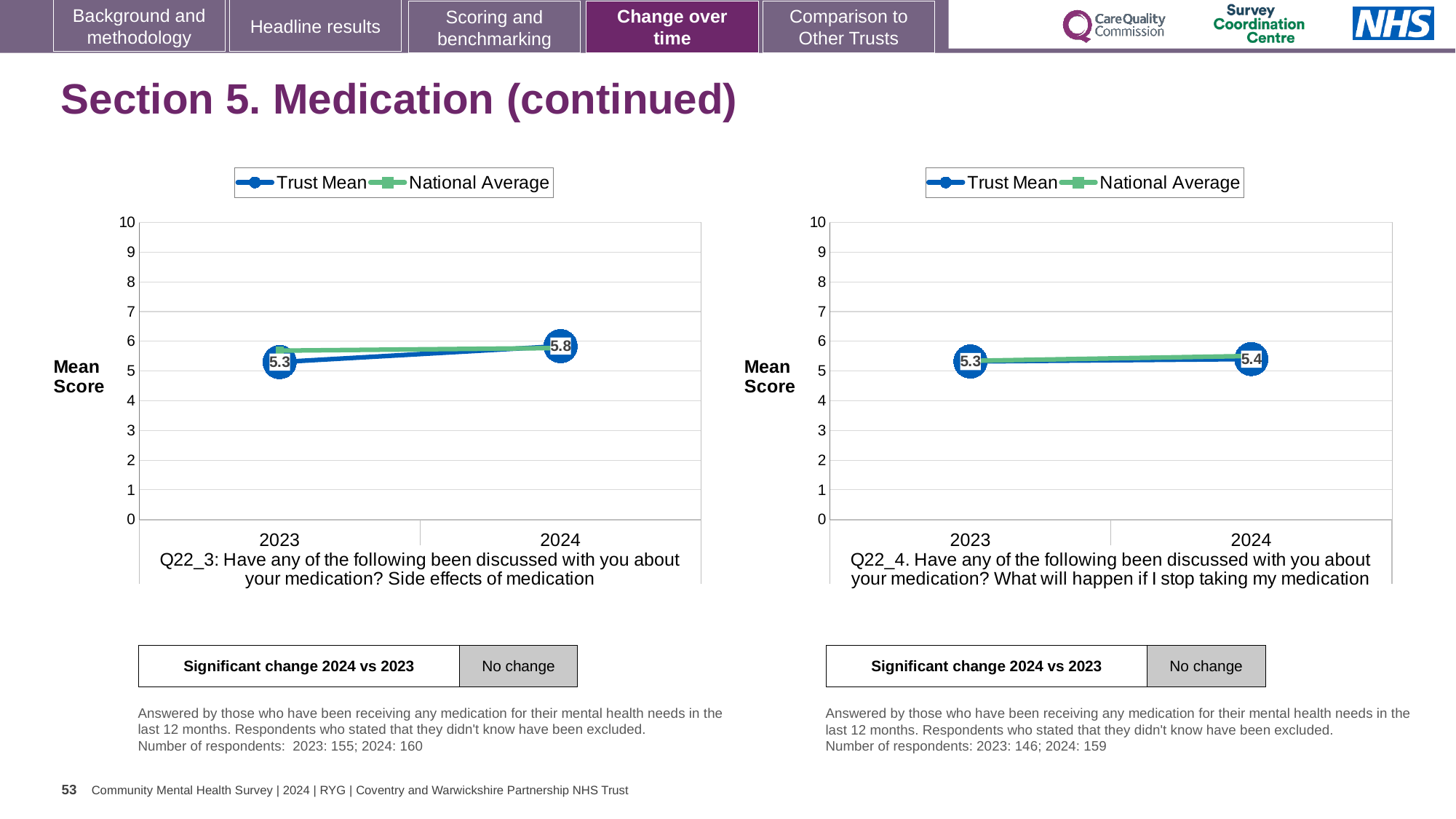
On the right chart (Q22_4), what is the Trust Mean for 2023? 5.3 On the right chart (Q22_4), what is the Trust Mean for 2024? 5.4 On the right chart (Q22_4), what is the difference between the Trust Mean in 2024 and 2023? 0.1 On the left chart (Q22_3), by how much did the Trust Mean change from 2023 to 2024? 0.5 On the right chart (Q22_4), is the National Average for 2024 greater or less than 6? less What kind of chart is used on the left (Q22_3)? line chart How many series does the legend of the right chart (Q22_4) list? 2 On the left chart (Q22_3), what is the Trust Mean for 2023? 5.3 How many years are plotted on the x axis of the left chart (Q22_3)? 2 On the left chart (Q22_3), does the Trust Mean rise or fall from 2023 to 2024? rise On the left chart (Q22_3), is the National Average for 2023 greater or less than 5? greater On the left chart (Q22_3), what is the Trust Mean for 2024? 5.8